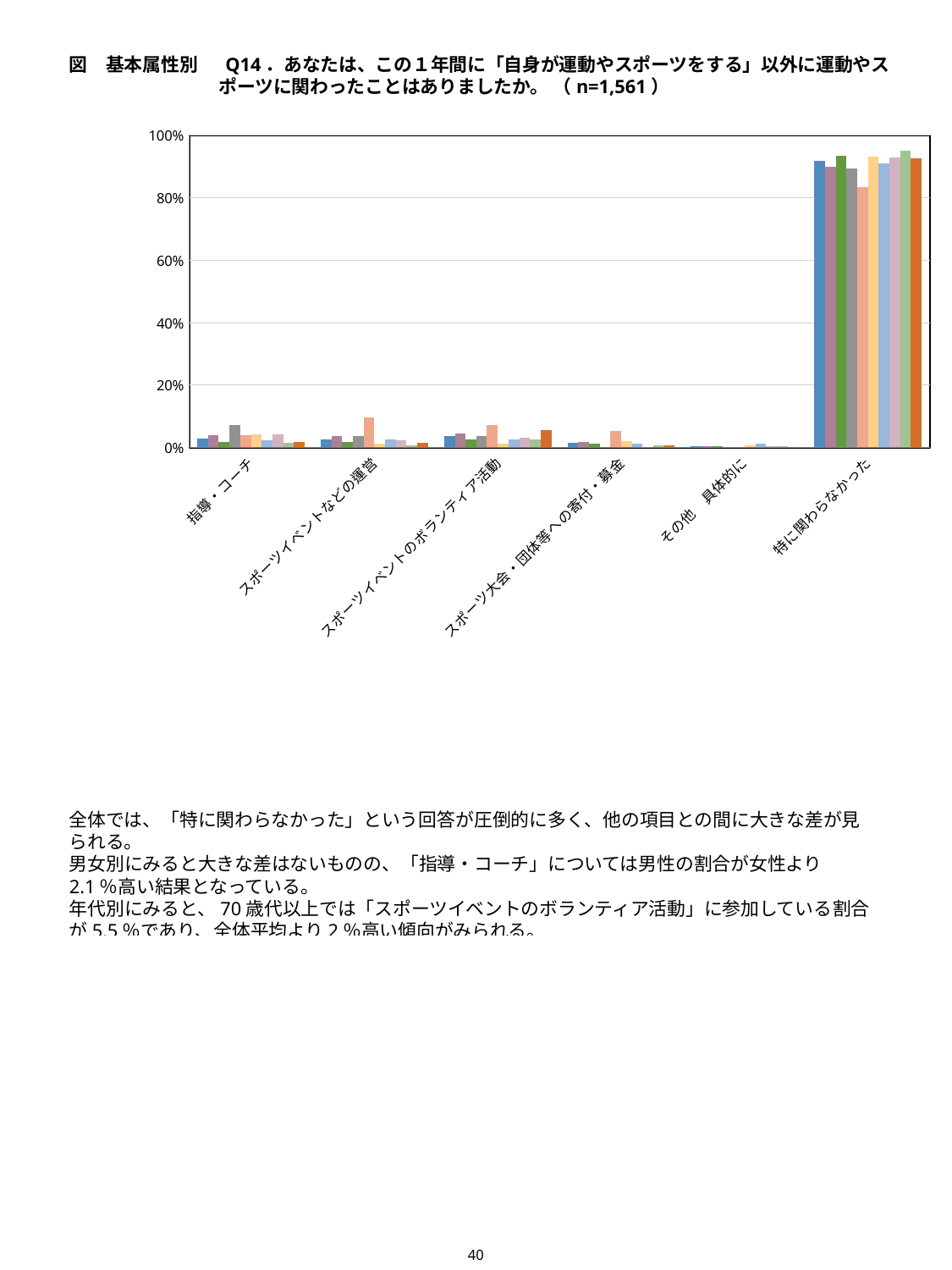
Which category has larger values, 特に関わらなかった or スポーツイベントなどの運営? 特に関わらなかった Which category has larger values, 指導・コーチ or その他 具体的に? 指導・コーチ What sample size (n) is stated in the chart title? n=1,561 What is the maximum value shown on the y axis of the chart? 100% Which category has the lowest values in the chart? その他 具体的に How many categories are shown along the x axis of the chart? 6 Are the values for 指導・コーチ greater or less than 20%? less Which category has the highest values in the chart? 特に関わらなかった What kind of chart is shown on the slide? bar chart Are the values for 特に関わらなかった greater or less than 80%? greater Are the values for スポーツイベントのボランティア活動 greater or less than 20%? less